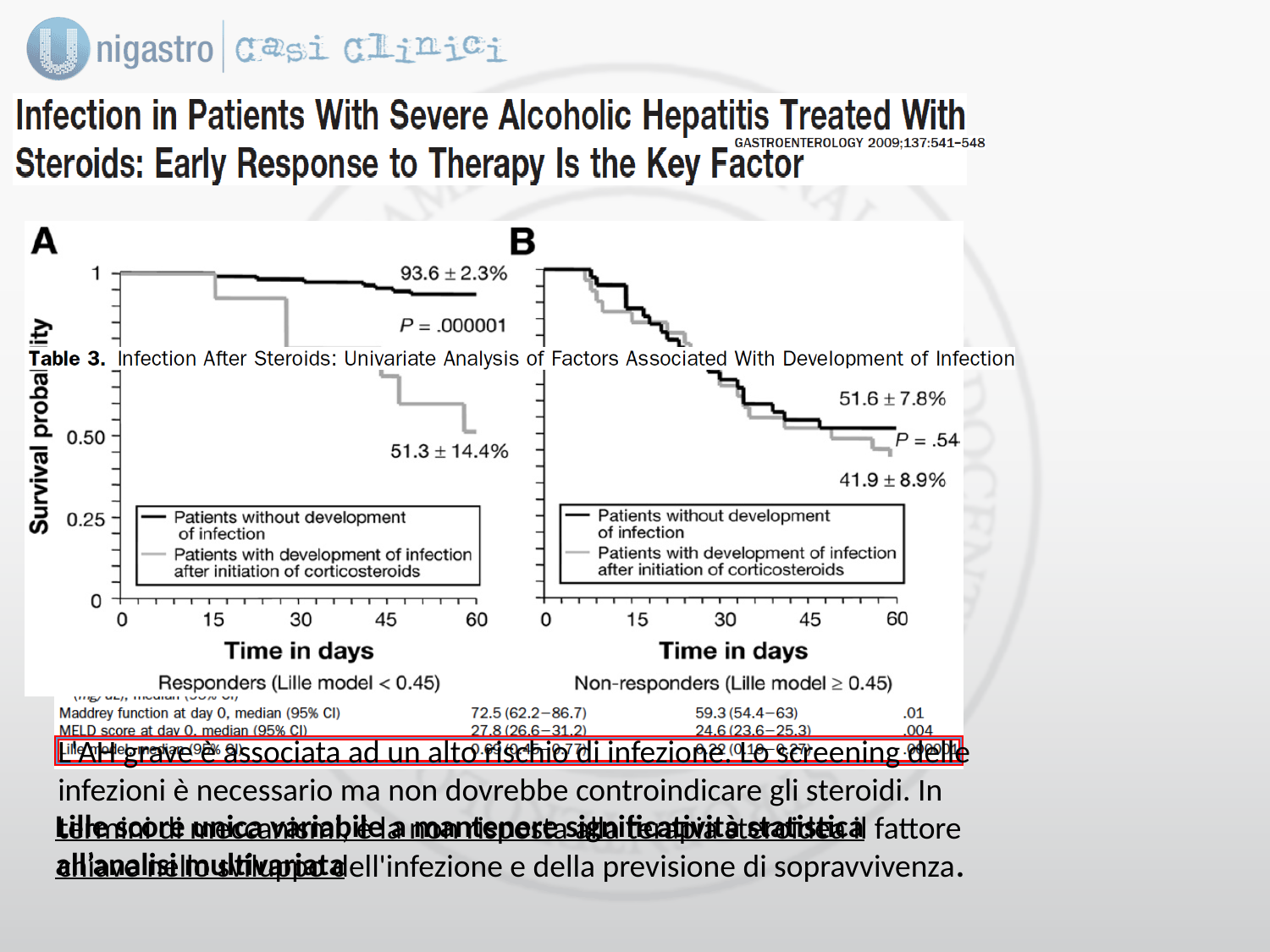
What is the label of the x axis in panel A? Time in days In panel B (Non-responders), what is the survival value printed for patients without development of infection? 51.6 ± 7.8% What is the maximum value shown on the x axis of panel B? 60 What P value is printed in panel A (Responders)? P = .000001 In panel B (Non-responders), what is the survival value printed for patients with development of infection? 41.9 ± 8.9% In panel A (Responders), what is the survival value printed for patients with development of infection after initiation of corticosteroids? 51.3 ± 14.4% What kind of chart is shown in panels A and B? Survival (Kaplan-Meier) curve / line chart In panel A (Responders), which group has the higher final survival probability: patients without infection or patients with infection? Patients without development of infection How many series does the legend in panel B list? 2 What P value is printed in panel B (Non-responders)? P = .54 In panel A (Responders), what is the survival value printed for patients without development of infection? 93.6 ± 2.3% In panel B (Non-responders), do the survival curves rise or fall over time in days? Fall